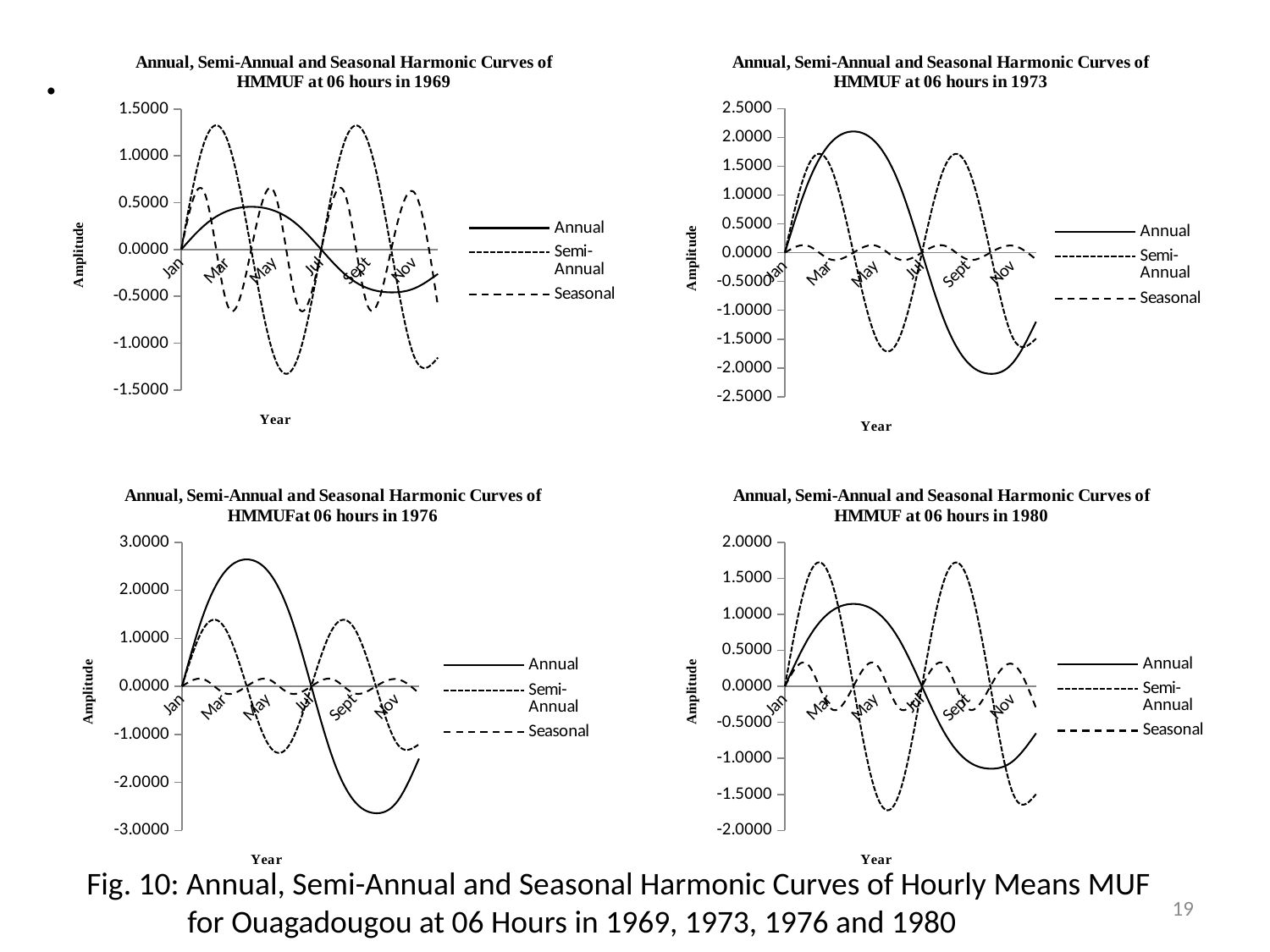
In the chart for HMMUF at 06 hours in 1969, which curve reaches a higher peak, Annual or Semi-Annual? Semi-Annual How many series does the legend list in the chart for HMMUF at 06 hours in 1973? 3 In the chart for HMMUF at 06 hours in 1980, which curve reaches a higher peak, Annual or Semi-Annual? Semi-Annual In the chart for HMMUF at 06 hours in 1976, is the peak value of the Annual curve greater or less than 2.0000? greater What kind of chart is the top-left chart (HMMUF at 06 hours in 1969)? line chart In the chart for HMMUF at 06 hours in 1976, which curve reaches the highest peak? Annual How many month labels are shown on the x axis of the chart for HMMUF at 06 hours in 1976? 6 In the chart for HMMUF at 06 hours in 1973, is the peak value of the Annual curve greater or less than 1.5000? greater In the chart for HMMUF at 06 hours in 1969, is the peak value of the Semi-Annual curve greater or less than 1.0000? greater In the chart for HMMUF at 06 hours in 1973, which curve has the smallest amplitude? Seasonal What is the y-axis title of the chart for HMMUF at 06 hours in 1980? Amplitude